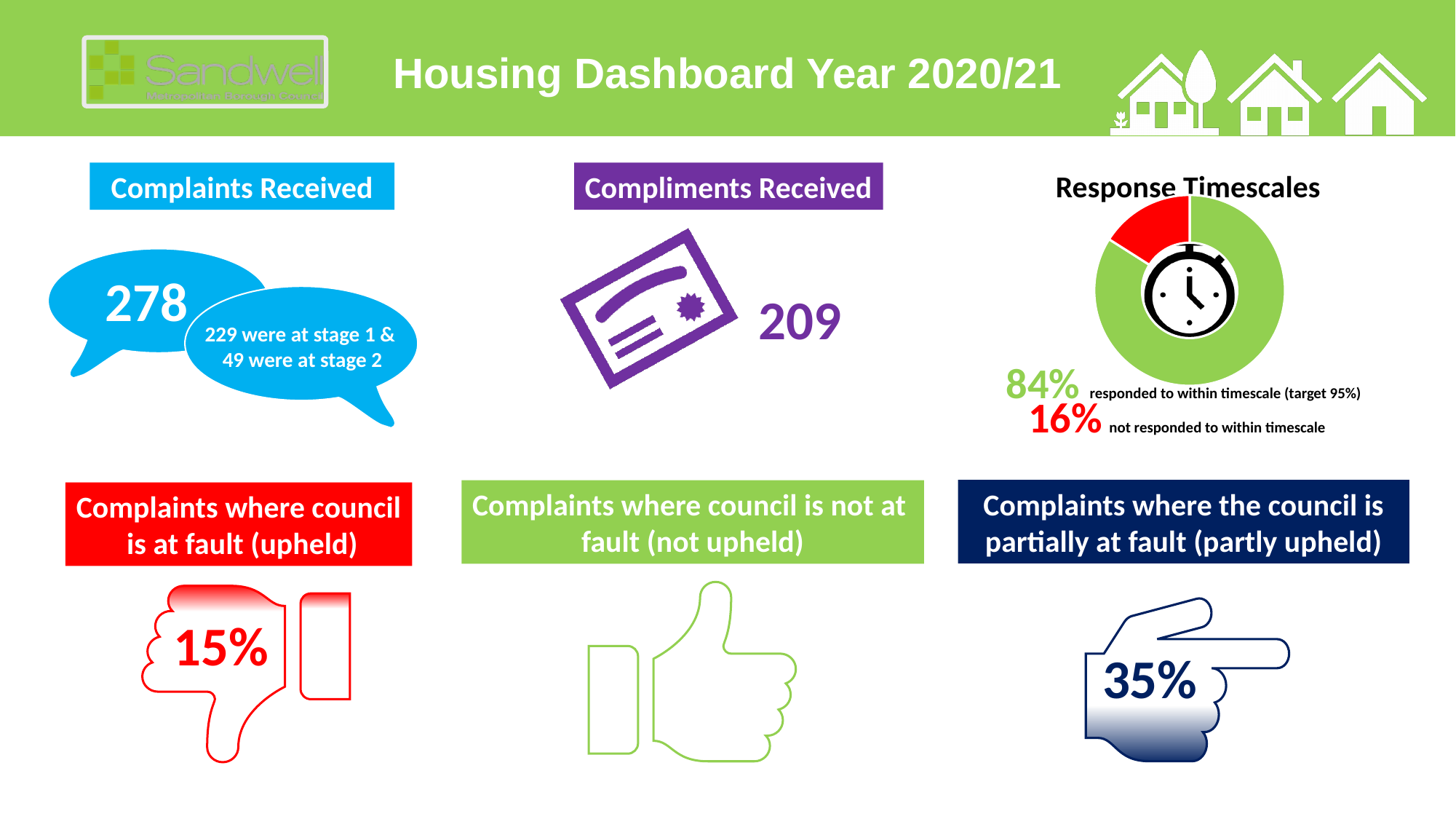
In the Response Timescales pie chart, which slice is larger: responded to within timescale or not responded to within timescale? responded to within timescale How many slices does the Response Timescales pie chart have? 2 What colour is the slice for responses not responded to within timescale in the Response Timescales pie chart? red In the Response Timescales pie chart, what share of responses were responded to within timescale? 84% In the Response Timescales pie chart, is the share responded to within timescale greater or less than the 95% target stated on the slide? less What kind of chart is shown under the "Response Timescales" heading? pie chart In the Response Timescales pie chart, which category has the smallest share? not responded to within timescale What is the title of the pie chart on the slide? Response Timescales In the Response Timescales pie chart, which category has the largest share? responded to within timescale In the Response Timescales pie chart, what is the difference in percentage points between the share responded to within timescale and the share not responded to within timescale? 68 percentage points In the Response Timescales pie chart, what share of responses were not responded to within timescale? 16%